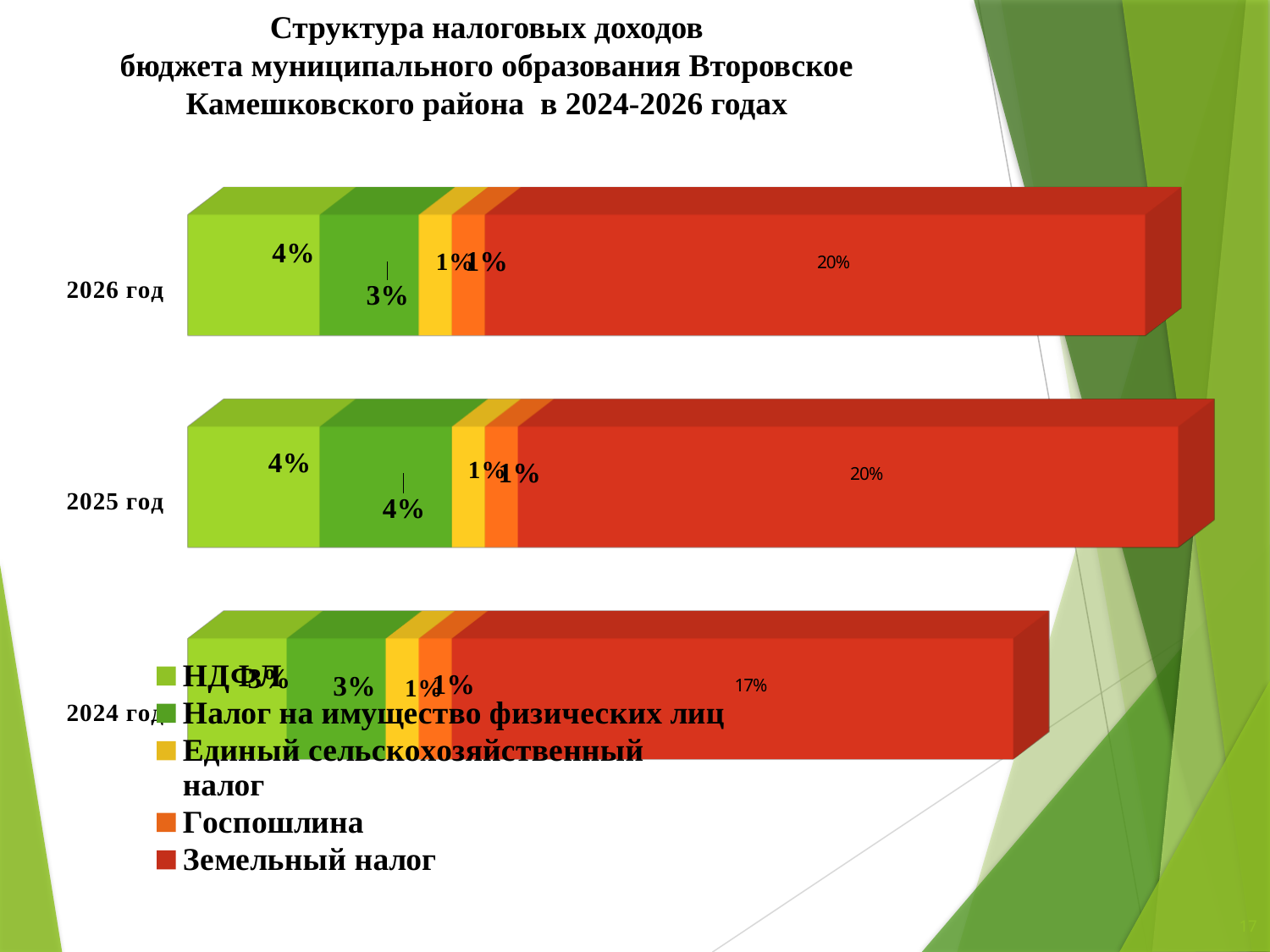
Which series is shown in red on the chart? Земельный налог What kind of chart is shown on the slide? stacked bar chart What is the value of Земельный налог for 2024 год? 17% What is the value of Налог на имущество физических лиц for 2026 год? 3% How many years (categories) are plotted on the chart? 3 What is the difference between the Земельный налог value for 2025 год and for 2024 год? 3% What is the value of Земельный налог for 2026 год? 20% What is the value of Госпошлина for 2026 год? 1% What is the value of НДФЛ for 2025 год? 4% What is the value of Налог на имущество физических лиц for 2025 год? 4% Which year has the lowest value for Земельный налог? 2024 год How many series does the legend list? 5